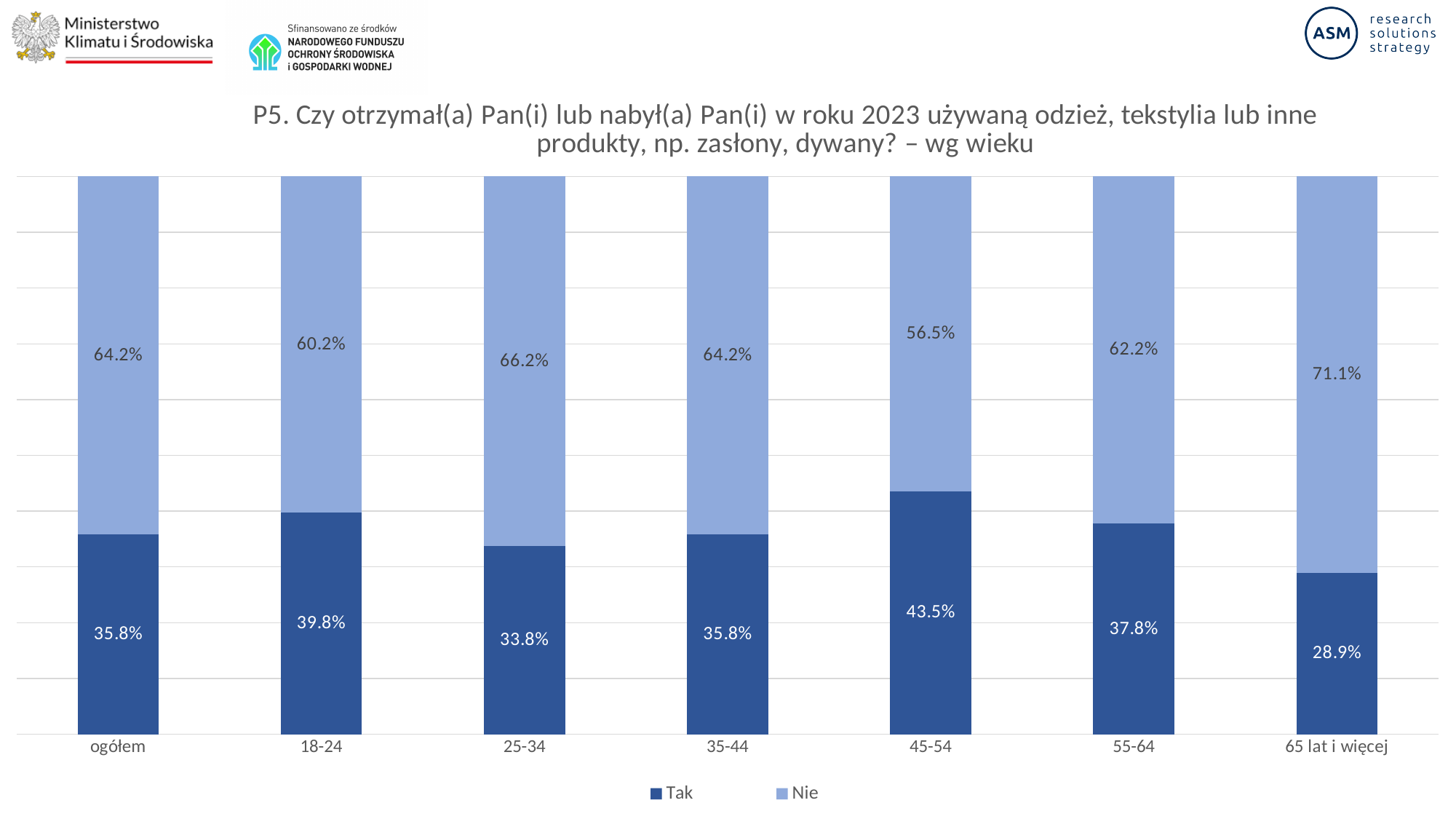
What is the difference between the 'Tak' values for 45-54 and 65 lat i więcej? 14.6% Which is larger: the 'Tak' value for 18-24 or for 25-34? 18-24 Which category has the highest 'Tak' value? 45-54 What is the 'Tak' value for the 45-54 age group? 43.5% Which category has the lowest 'Tak' value? 65 lat i więcej How many series does the legend list? 2 How many categories are shown on the x axis? 7 What is the 'Nie' value for the 65 lat i więcej age group? 71.1% What kind of chart is shown on the slide? Stacked bar chart Which category has the highest 'Nie' value? 65 lat i więcej What is the 'Tak' value for ogółem? 35.8% What is the 'Nie' value for the 18-24 age group? 60.2%